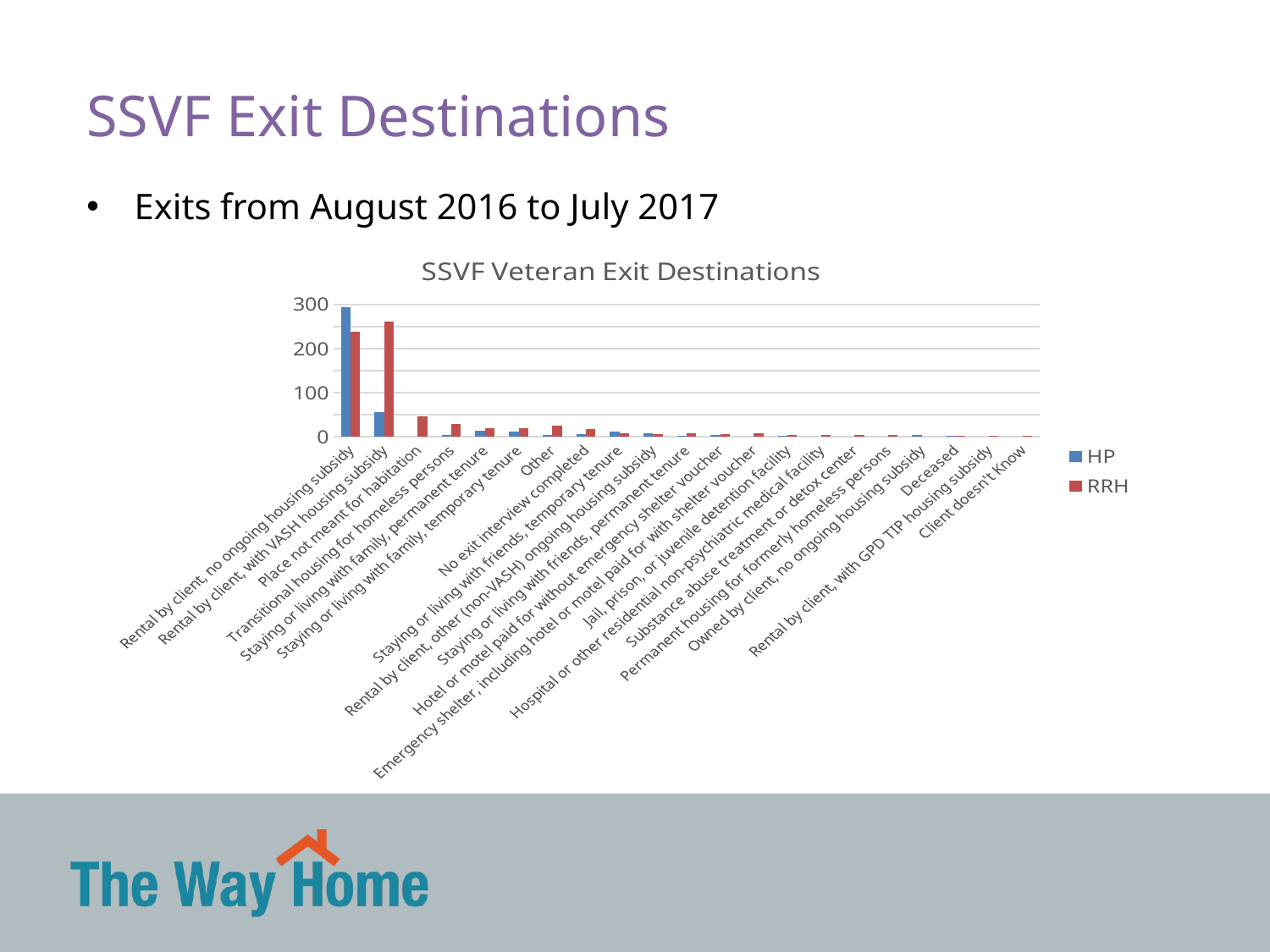
What is the title of the chart? SSVF Veteran Exit Destinations Is the HP value for 'Rental by client, with VASH housing subsidy' greater or less than 100? less For 'Rental by client, no ongoing housing subsidy', which series has the larger value, HP or RRH? HP Is the RRH value for 'Rental by client, with VASH housing subsidy' greater or less than 200? greater How many series does the legend list? 2 Is the HP value for 'Rental by client, no ongoing housing subsidy' greater or less than 200? greater What are the two series named in the legend? HP and RRH Which exit destination has the highest HP value? Rental by client, no ongoing housing subsidy What type of chart is shown on the slide? Bar chart Which exit destination has the highest RRH value? Rental by client, with VASH housing subsidy Do the values generally rise or fall moving from left to right along the x axis? Fall For 'Rental by client, with VASH housing subsidy', which series has the larger value, HP or RRH? RRH